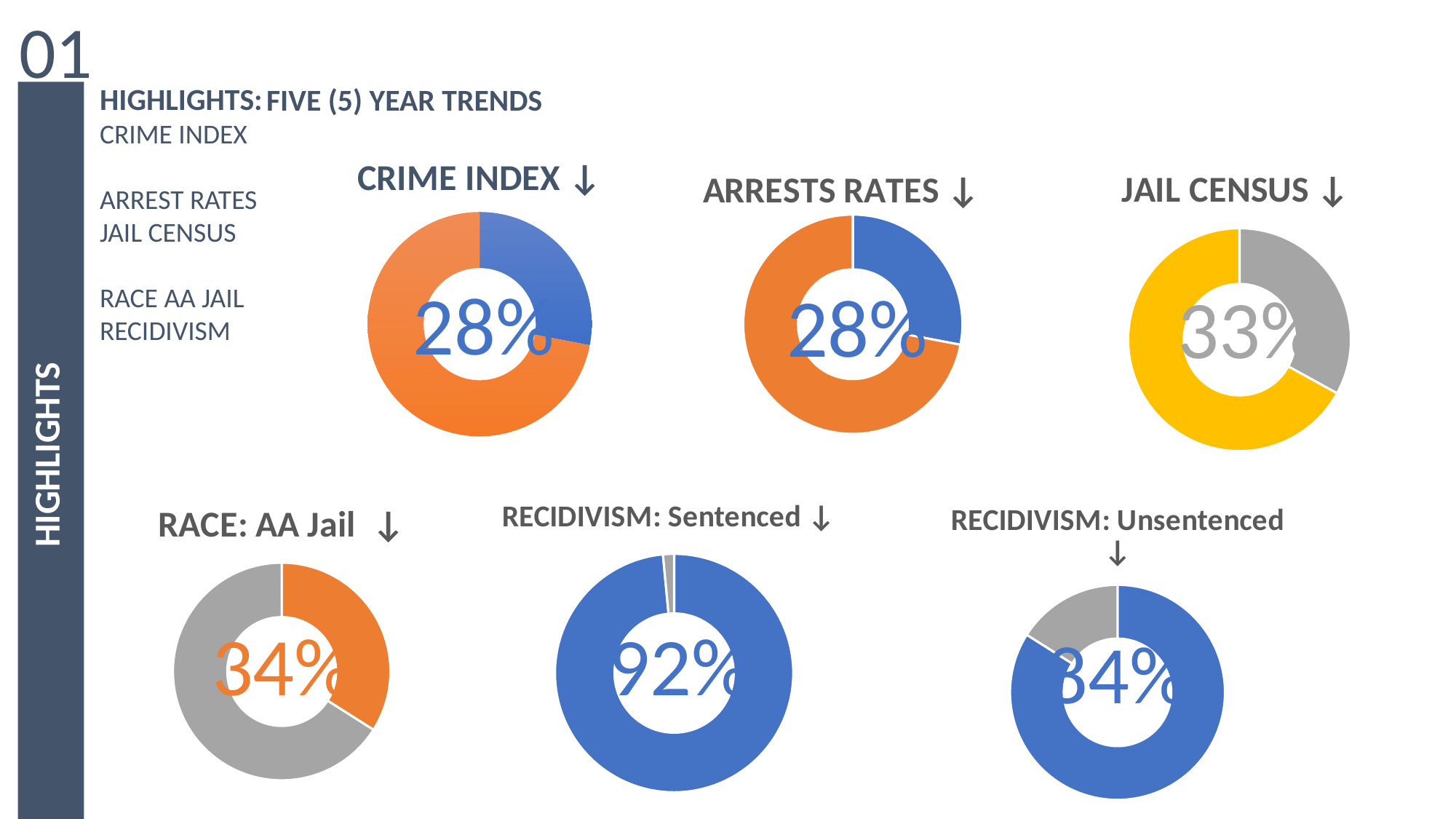
Which chart on the slide shows the highest percentage in its centre? RECIDIVISM: Sentenced How many donut charts are on the slide? 6 What percentage is shown in the centre of the CRIME INDEX donut chart? 28% What percentage is shown in the centre of the RACE: AA Jail donut chart? 34% Which shows a larger percentage, the JAIL CENSUS chart or the RACE: AA Jail chart? RACE: AA Jail What is the difference between the percentage in the RECIDIVISM: Sentenced chart and the percentage in the CRIME INDEX chart? 64 percentage points What percentage is shown in the centre of the JAIL CENSUS donut chart? 33% What kind of charts are used on this slide? Donut (pie) charts In the RECIDIVISM: Unsentenced chart, is the blue portion greater or less than 50% of the donut? greater What percentage is shown in the centre of the ARRESTS RATES donut chart? 28% What percentage is shown in the centre of the RECIDIVISM: Sentenced donut chart? 92% What colour is the larger segment of the JAIL CENSUS donut chart? Yellow